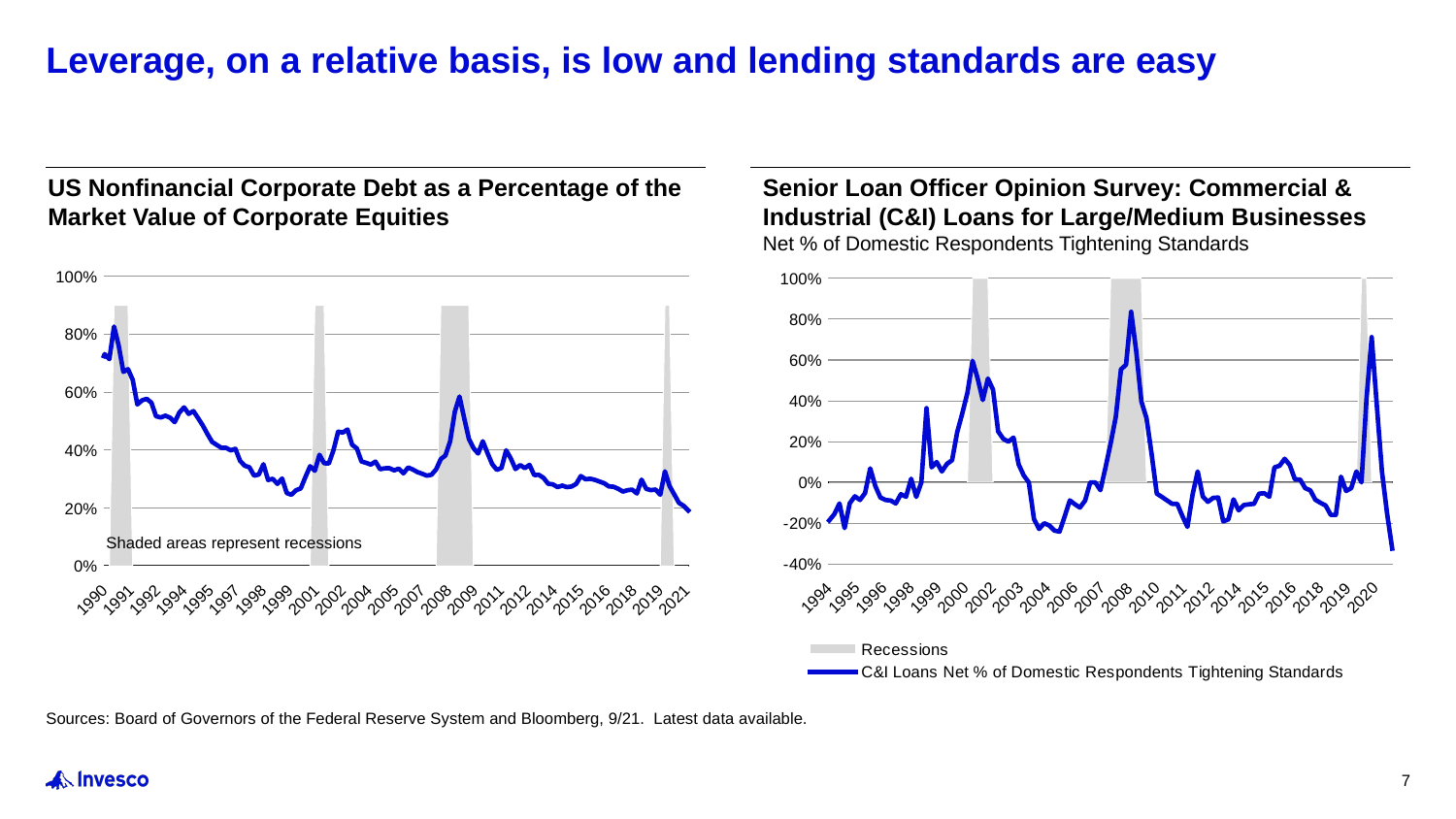
What kind of chart is the right chart, 'Senior Loan Officer Opinion Survey: Commercial & Industrial (C&I) Loans for Large/Medium Businesses'? Line chart In the left chart, does the line overall rise or fall from 1990 to 2021? fall In the left chart, is the value at the start of the series in 1990 greater or less than 60%? greater In the right chart, is the final value at the end of the series greater or less than -20%? less What kind of chart is the left chart, 'US Nonfinancial Corporate Debt as a Percentage of the Market Value of Corporate Equities'? Line chart In the left chart, is the value at the end of the series in 2021 greater or less than 40%? less What is the subtitle of the right chart? Net % of Domestic Respondents Tightening Standards How many entries does the legend of the right chart list? 2 In the right chart, does the line rise or fall from its 2008 peak to 2010? fall According to the note on the left chart, what do the shaded areas represent? Recessions